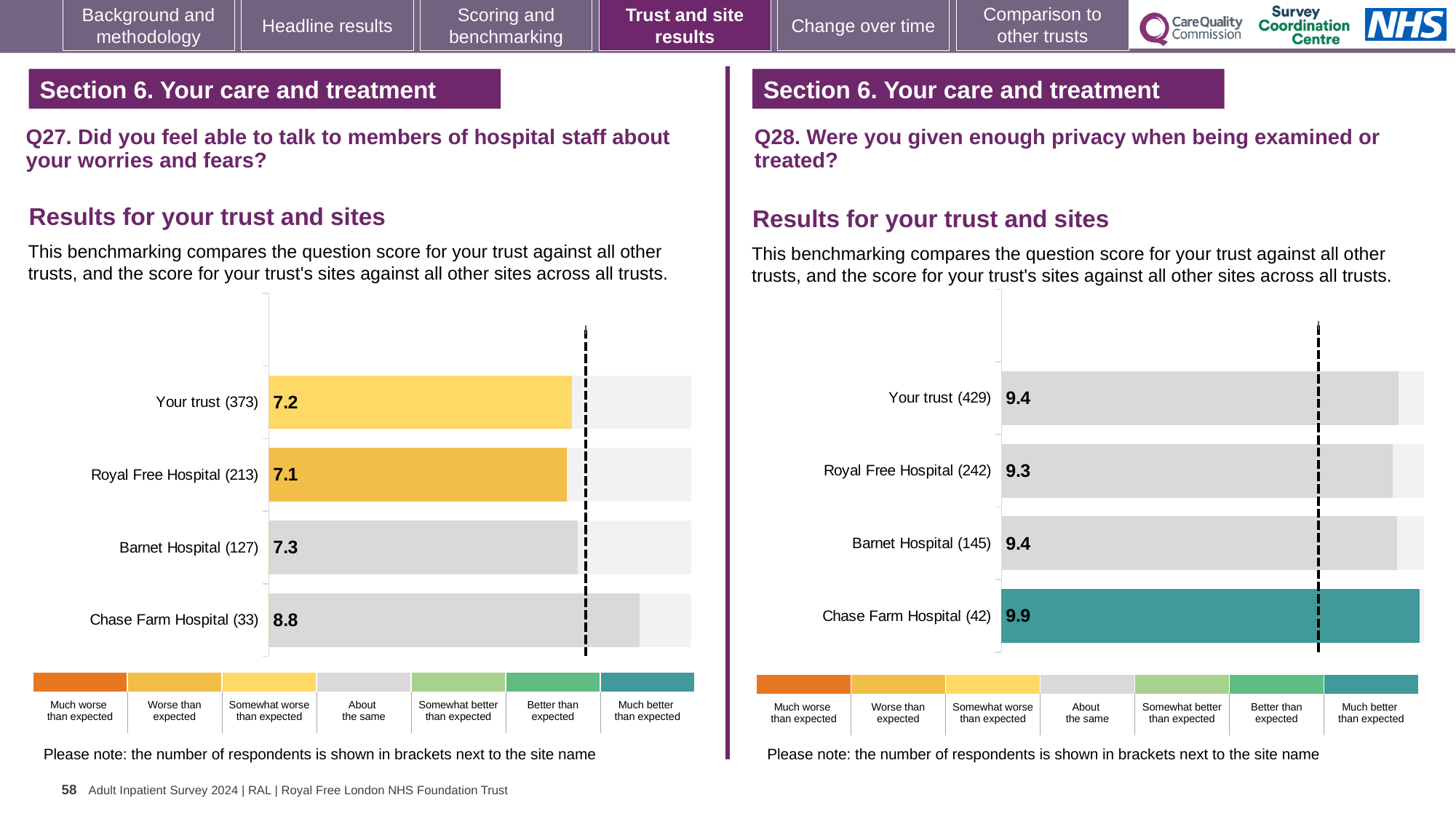
In the Q28 chart on the right, what is the difference between the scores for Chase Farm Hospital and Royal Free Hospital? 0.6 In the Q27 chart on the left, what is the score for Chase Farm Hospital? 8.8 In the Q27 chart on the left, what is the difference between the scores for Chase Farm Hospital and Your trust? 1.6 In the Q28 chart on the right, which site has the highest score? Chase Farm Hospital What kind of chart is used for the Q28 results on the right? Bar chart In the Q28 chart on the right, what is the score for Royal Free Hospital? 9.3 In the Q28 chart on the right, which benchmark category does the colour of the Chase Farm Hospital bar correspond to? Much better than expected In the Q28 chart on the right, which has the larger score, Chase Farm Hospital or Barnet Hospital? Chase Farm Hospital In the Q27 chart on the left, which site has the lowest score? Royal Free Hospital In the Q27 chart on the left, which site has the highest score? Chase Farm Hospital How many sites (bars) are shown in the Q27 chart on the left? 4 In the Q27 chart on the left, what is the score for Your trust? 7.2